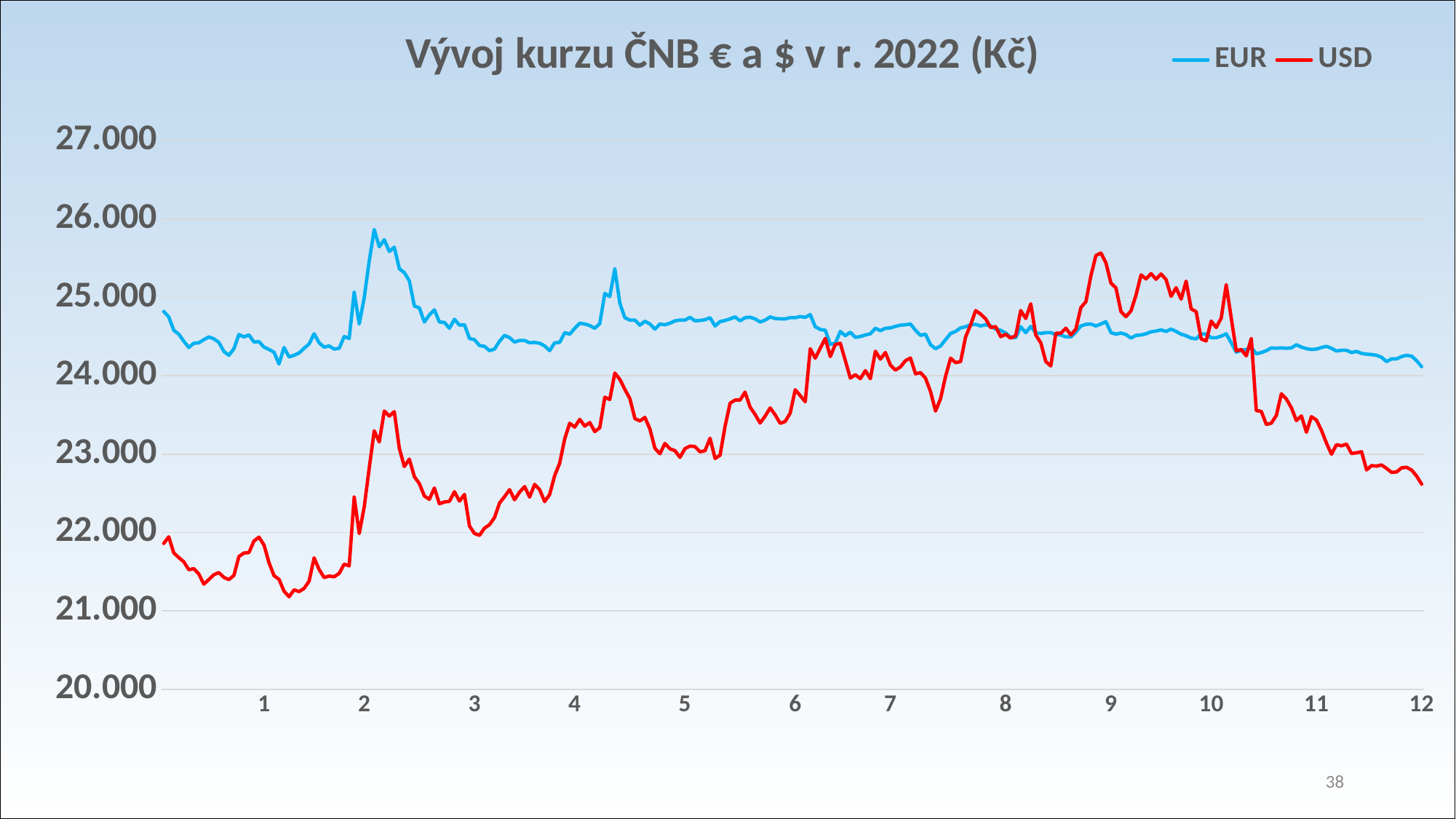
Which colour is used for the USD series? red At month 3, which series has the higher value, EUR or USD? EUR Is the USD value at month 11 greater or less than 24.000? less What is the title of the chart? Vývoj kurzu ČNB € a $ v r. 2022 (Kč) How many series does the legend list? 2 Which series reaches the lowest value on the chart? USD At month 9, which series has the higher value, EUR or USD? USD Is the USD value at month 3 greater or less than 23.000? less What kind of chart is shown on the slide? line chart Does the USD series rise or fall between month 10 and month 12? fall Is the USD value at month 12 greater or less than 23.000? less